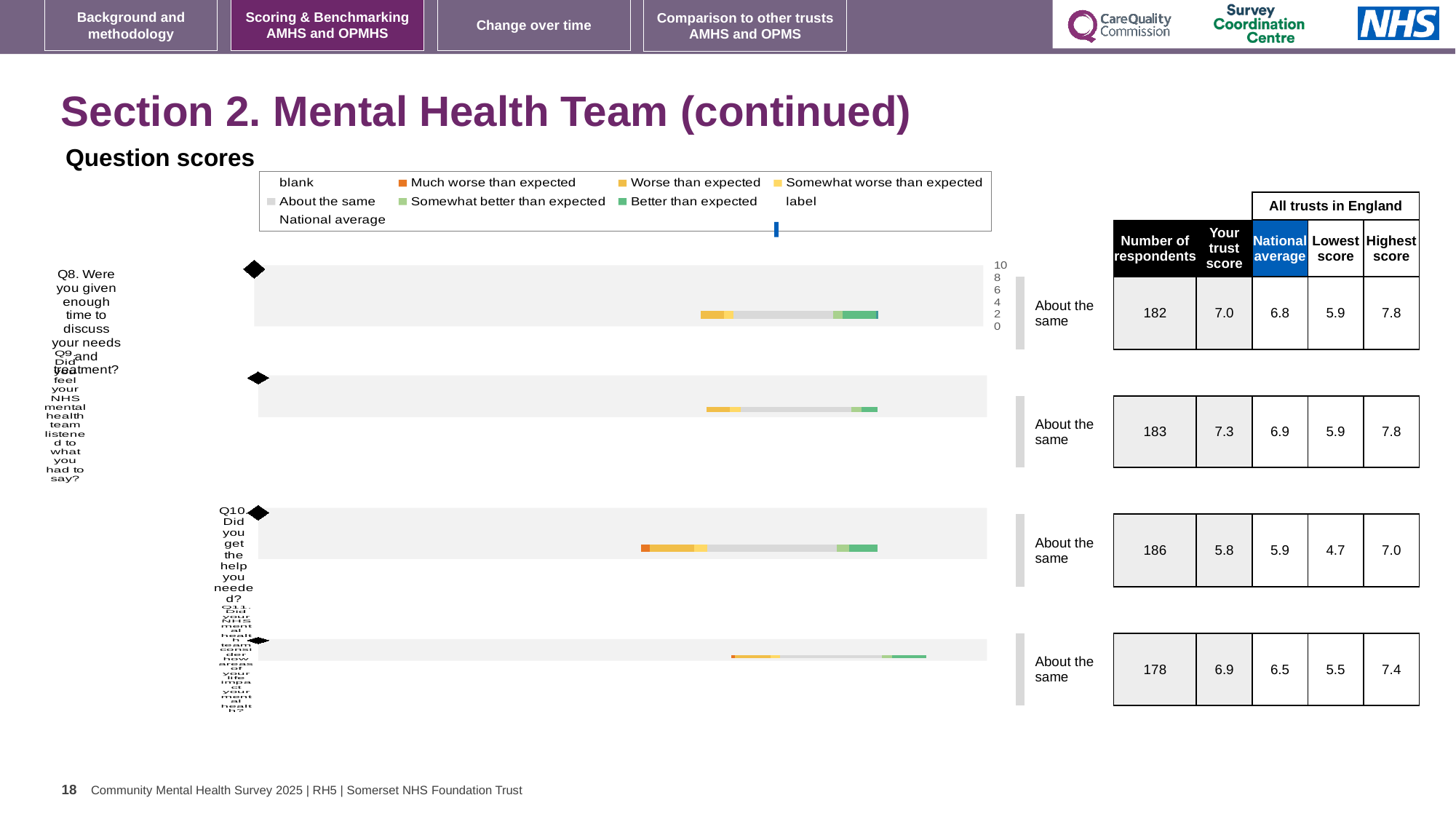
How many entries does the legend of the Question scores chart list? 9 In the table beside the chart, what is the number of respondents for Q8? 182 How many questions (bars) are plotted in the Question scores chart? 4 What is the title shown above the chart on this slide? Question scores Which question has the lowest 'Your trust score' in the table? Q10 (5.8) Which legend entry in the Question scores chart is shown in grey? About the same In the table beside the chart, what is the national average for Q11? 6.5 For Q9, which is larger in the table: the trust score or the national average? Your trust score (7.3) What kind of chart is used to show the question scores on this slide? bar chart Which question has the highest number of respondents in the table? Q10 (186) In the table, what is the difference between the highest score and the lowest score for Q11? 1.9 In the table beside the chart, what is the 'Your trust score' for Q10? 5.8